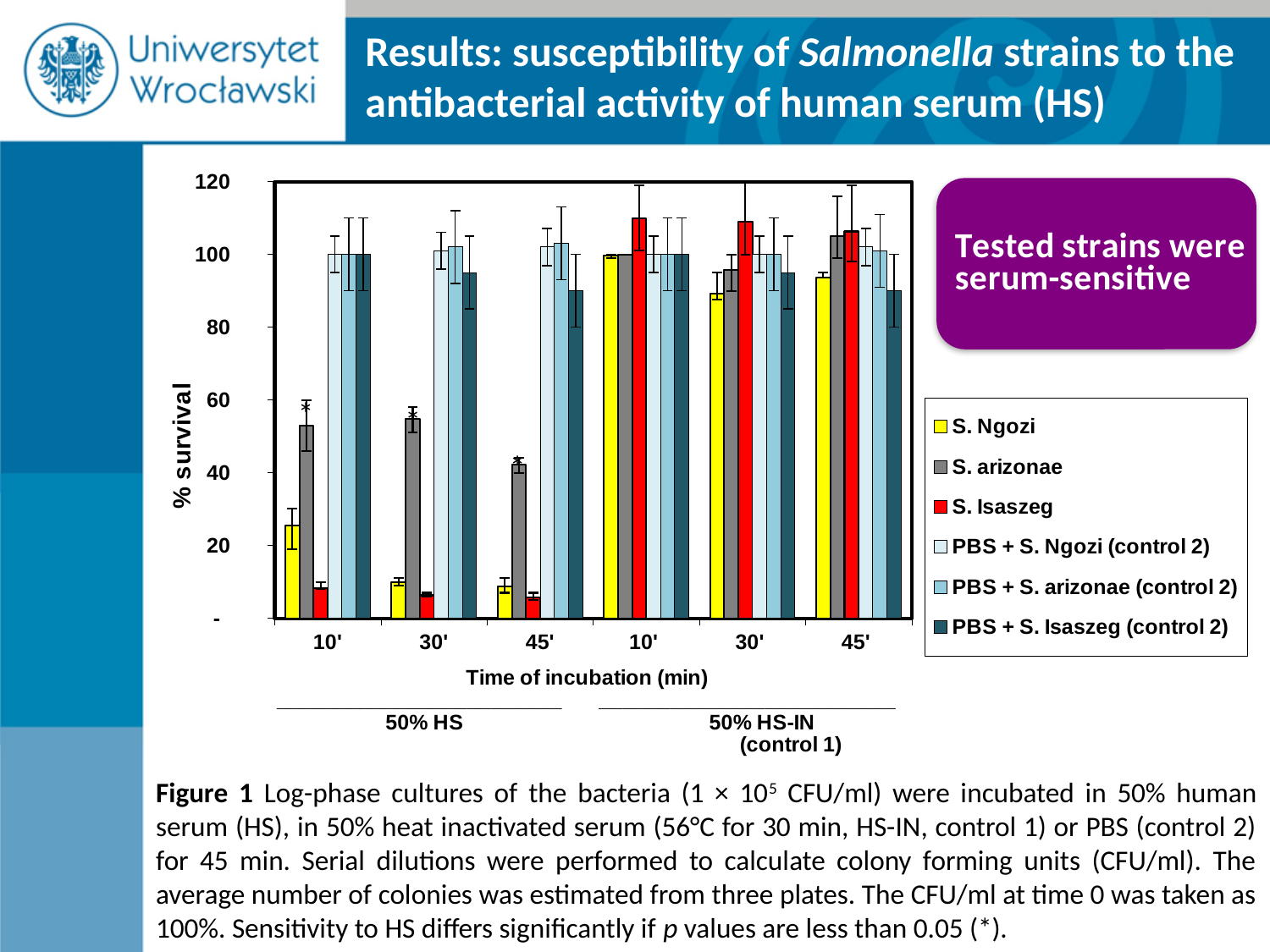
Does the % survival of S. Ngozi in 50% HS rise or fall from 10' to 45'? fall What is the title of the x axis? Time of incubation (min) What is the title of the y axis? % survival How many time-point categories are shown along the x axis? 6 At 30' under 50% HS, which is larger: S. arizonae or S. Ngozi? S. arizonae Among the three strains incubated in 50% HS at 10', which has the lowest % survival? S. Isaszeg Is the value for S. Ngozi at 30' under 50% HS greater or less than 20? less Is the value for S. Ngozi at 10' under 50% HS greater or less than 40? less Is the value for S. arizonae at 10' under 50% HS greater or less than 40? greater What kind of chart is shown on the slide? bar chart How many series does the legend list? 6